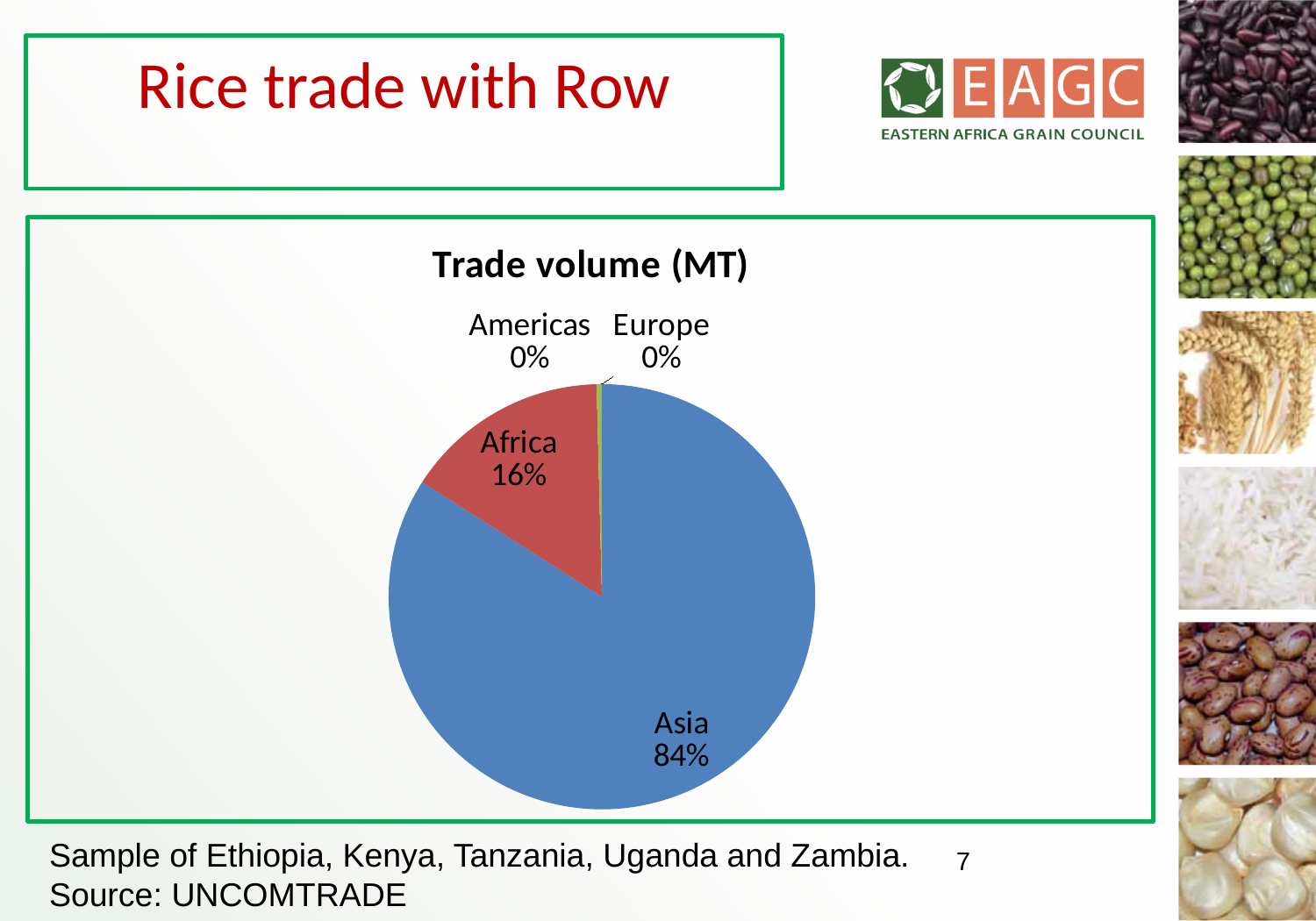
What percentage is shown for Europe? 0% What colour is the slice for Africa? Red What share of the pie does Africa hold? 16% Is the share for Asia greater or less than 50%? greater Which region has the largest slice of the pie? Asia What share of the pie does Asia hold? 84% What is the title of the chart? Trade volume (MT) What is the difference in percentage points between Asia's and Africa's shares? 68 What kind of chart is shown on the slide? Pie chart How many regions are labelled on the pie chart? 4 What percentage is shown for the Americas? 0% Which is larger, the share for Africa or the share for Asia? Asia